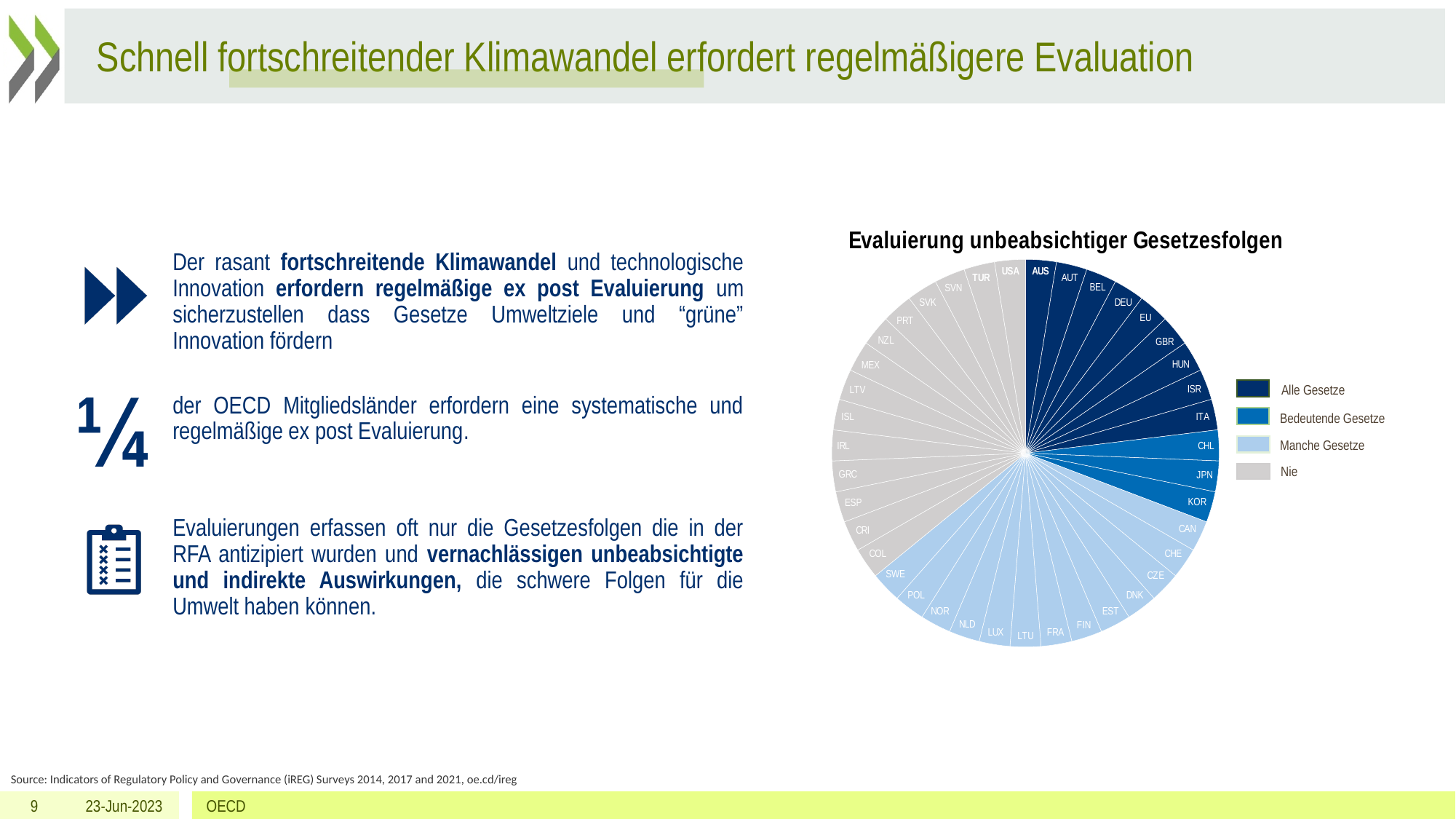
In the pie chart, which category covers more country slices: "Nie" or "Bedeutende Gesetze"? Nie What colour is used for the "Nie" category in the pie chart legend? Grey Which legend category does the slice for USA belong to in the pie chart? Nie What is the title of the pie chart on the slide? Evaluierung unbeabsichtiger Gesetzesfolgen In the pie chart, which category covers more country slices: "Alle Gesetze" or "Bedeutende Gesetze"? Alle Gesetze Which legend category does the slice for AUS belong to in the pie chart? Alle Gesetze Which legend category does the slice for JPN belong to in the pie chart? Bedeutende Gesetze How many country slices in the pie chart are coloured as "Bedeutende Gesetze"? 3 Which legend category does the slice for FRA belong to in the pie chart? Manche Gesetze What kind of chart is shown under the title "Evaluierung unbeabsichtiger Gesetzesfolgen"? Pie chart Which legend category covers the fewest country slices in the pie chart? Bedeutende Gesetze How many categories does the legend of the pie chart list? 4